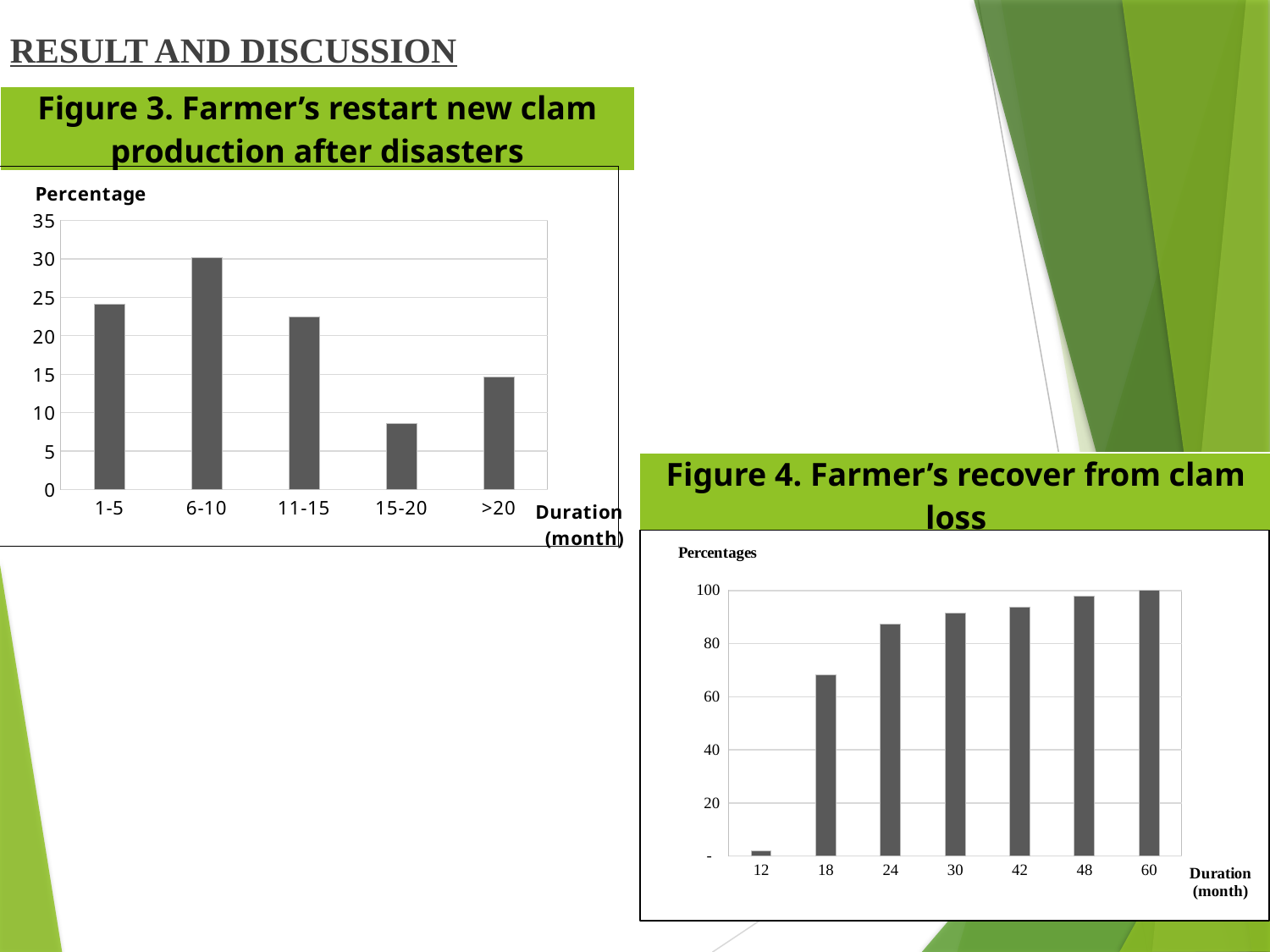
In Figure 3, is the value for 15-20 greater or less than 10? less In Figure 3, which is larger, the value for 11-15 or the value for >20? 11-15 In Figure 3, which duration category has the lowest percentage? 15-20 How many duration categories are shown in Figure 3? 5 In Figure 3, which duration category has the highest percentage? 6-10 What kind of chart is Figure 4? bar chart In Figure 4, is the value for 18 months greater or less than 60? greater In Figure 4, which duration has the highest percentage? 60 How many duration categories are shown in Figure 4? 7 In Figure 4, which duration has the lowest percentage? 12 In Figure 3, is the value for 1-5 greater or less than 20? greater In Figure 4, do the values rise or fall as duration increases along the x axis? rise